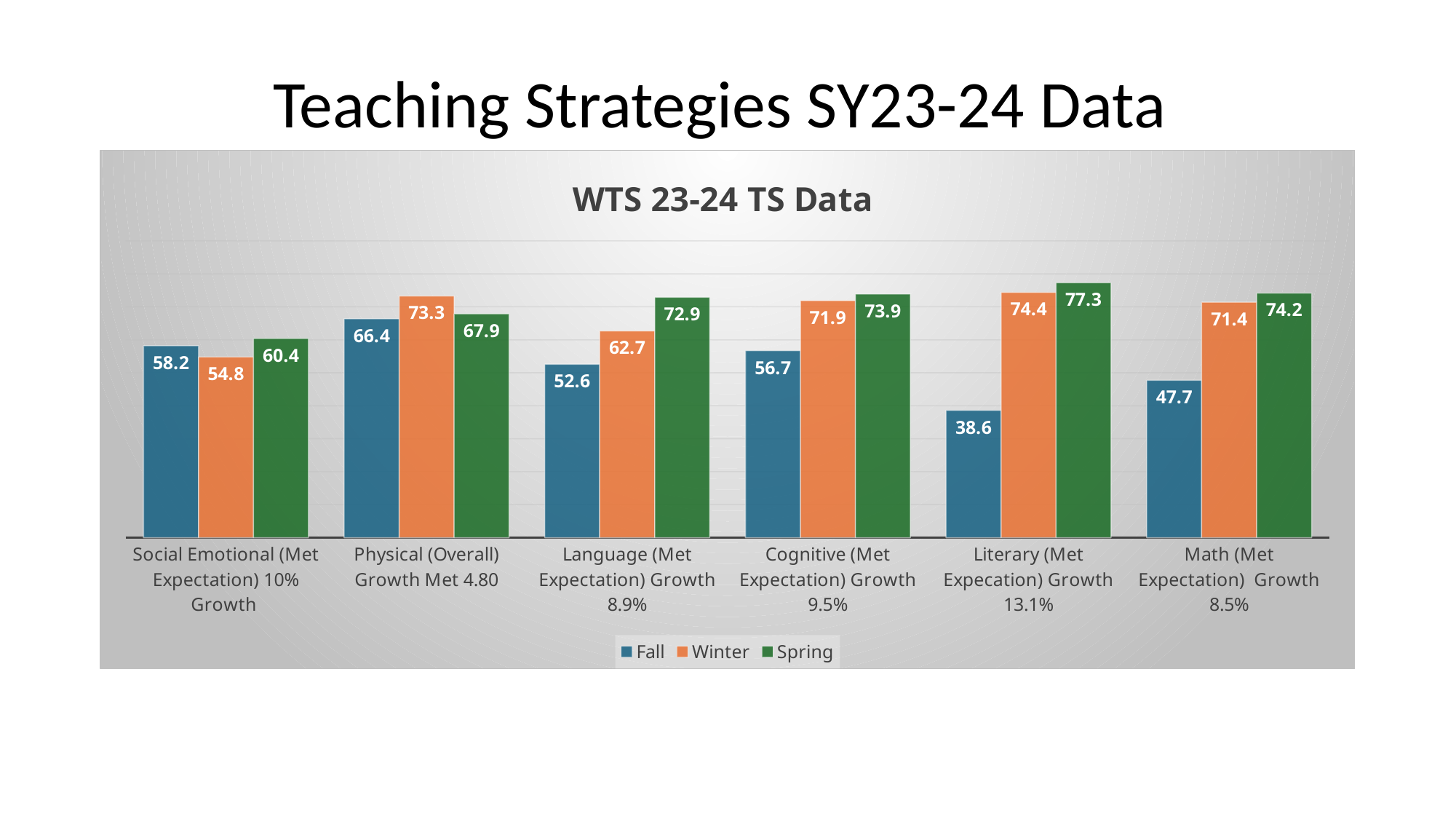
What is the difference between the Spring and Fall values for Literary (Met Expecation) Growth 13.1%? 38.7 How many series does the legend list? 3 What kind of chart is shown on the slide? Bar chart What is the Fall value for Social Emotional (Met Expectation) 10% Growth? 58.2 Which category has the highest Spring value? Literary (Met Expecation) Growth 13.1% Which is larger for Physical (Overall) Growth Met 4.80: the Winter value or the Spring value? Winter What is the Winter value for Math (Met Expectation) Growth 8.5%? 71.4 What is the difference between the Winter and Fall values for Language (Met Expectation) Growth 8.9%? 10.1 What is the Spring value for Literary (Met Expecation) Growth 13.1%? 77.3 How many categories are shown on the x axis? 6 What is the title of the chart? WTS 23-24 TS Data Which category has the lowest Fall value? Literary (Met Expecation) Growth 13.1%